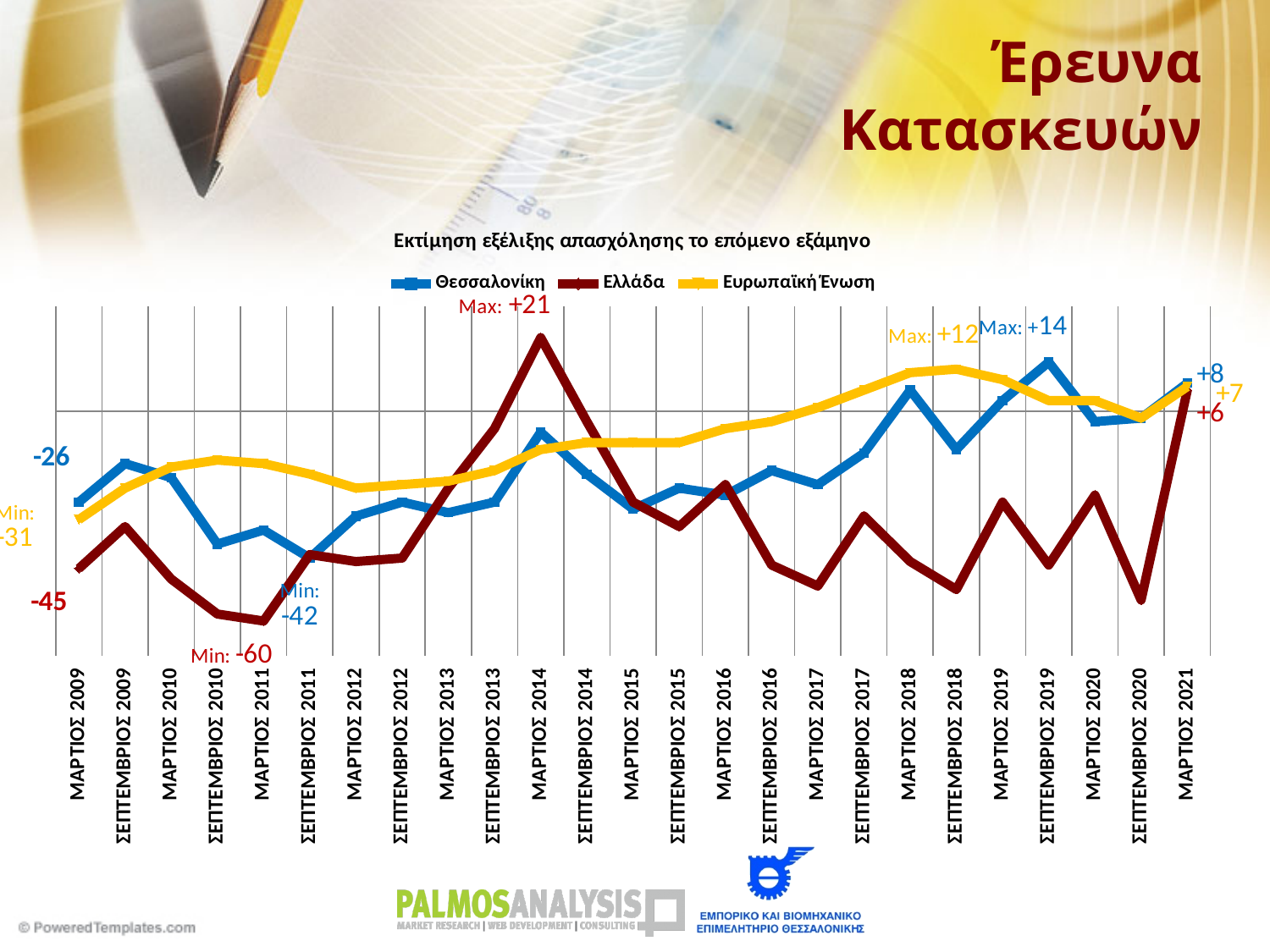
What is the minimum value of the Θεσσαλονίκη series? -42 How many series does the legend list? 3 Which series has the higher value in ΜΑΡΤΙΟΣ 2009, Θεσσαλονίκη or Ελλάδα? Θεσσαλονίκη What is the value for Ευρωπαϊκή Ένωση in ΜΑΡΤΙΟΣ 2021? +7 What is the value for Ελλάδα in ΜΑΡΤΙΟΣ 2021? +6 In which period does the Ελλάδα series reach its minimum of -60? ΜΑΡΤΙΟΣ 2011 What kind of chart is shown on the slide? line chart What is the maximum value reached by the Ελλάδα series, and in which period? +21, ΜΑΡΤΙΟΣ 2014 What is the title of the chart? Εκτίμηση εξέλιξης απασχόλησης το επόμενο εξάμηνο How many time periods are shown on the x axis? 25 What is the difference between the Θεσσαλονίκη value in ΜΑΡΤΙΟΣ 2021 (+8) and the Ελλάδα value in ΜΑΡΤΙΟΣ 2021 (+6)? 2 What is the value for Θεσσαλονίκη in ΜΑΡΤΙΟΣ 2009? -26